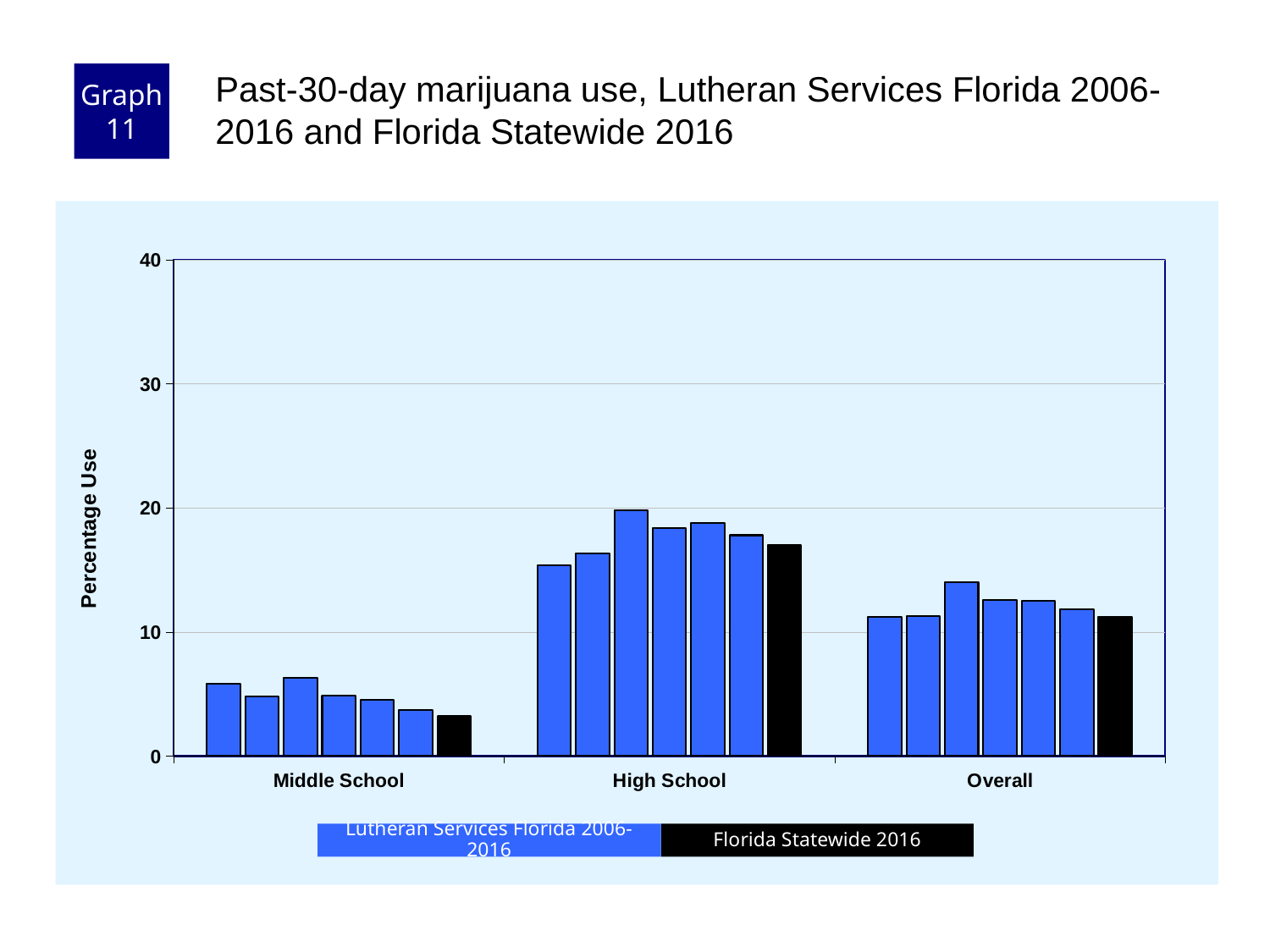
What kind of chart is shown on the slide? bar chart How many categories are shown on the x axis? 3 What colour represents Florida Statewide 2016 in the legend? black What is the label on the y axis? Percentage Use Is the Florida Statewide 2016 value for Middle School greater or less than 10? less Which is larger, the Florida Statewide 2016 value for High School or for Middle School? High School How many series does the legend list? 2 Which category has the lowest bars? Middle School Which category has the highest bars? High School Is the Florida Statewide 2016 value for High School greater or less than 20? less Is the Florida Statewide 2016 value for Overall greater or less than 20? less